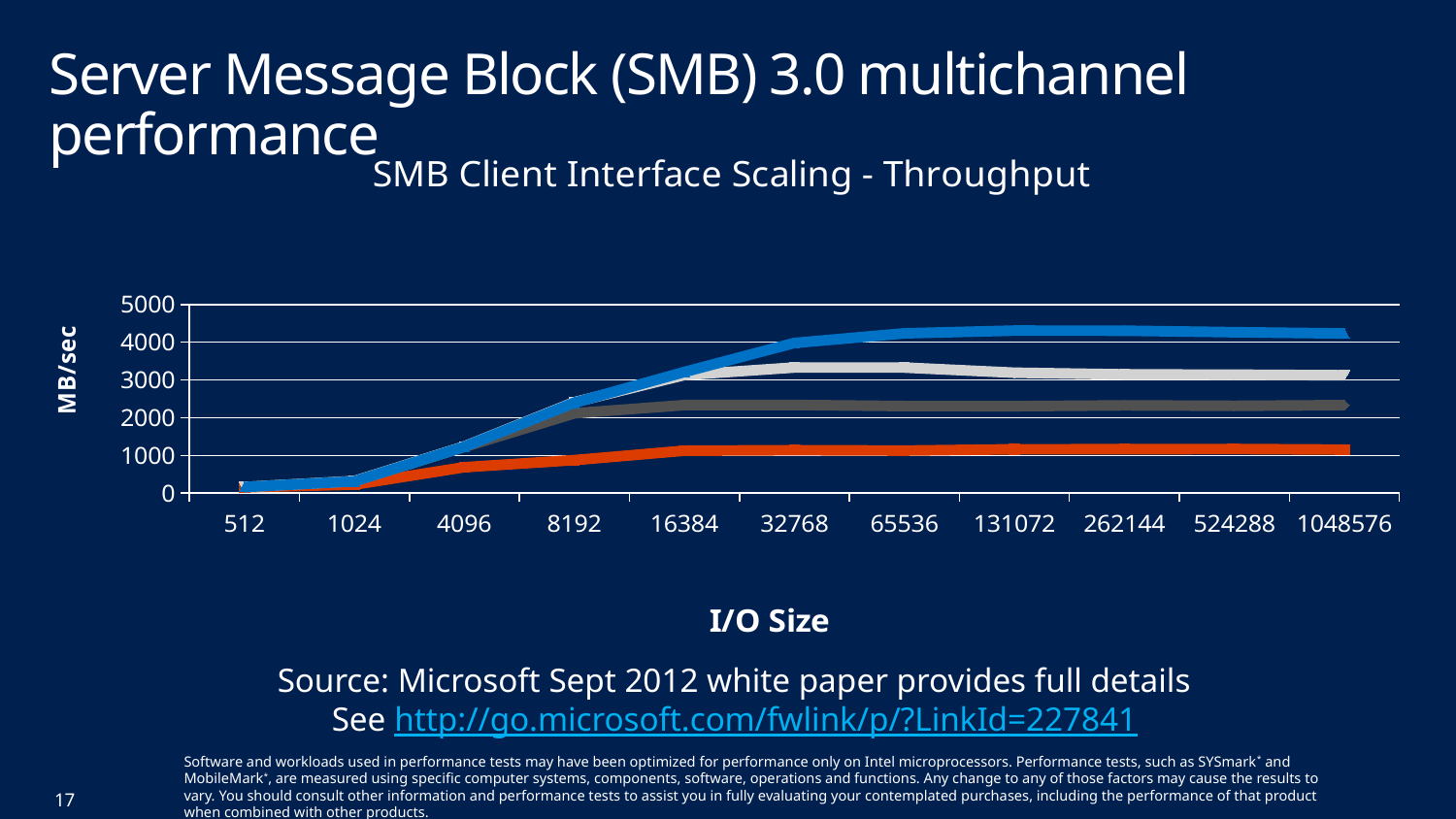
How many I/O size categories are shown on the x axis? 11 Is the value of the blue line at I/O size 512 greater or less than 1000? less Does the blue line generally rise or fall as I/O size increases from 512 to 32768? rise Is the value of the blue line at I/O size 1048576 greater or less than 4000? greater What kind of chart is shown on the slide? line chart What is the title of the chart? SMB Client Interface Scaling - Throughput Is the value of the orange line at I/O size 1048576 greater or less than 2000? less Which line has the lowest value at I/O size 1048576? the orange line At I/O size 65536, which line has the larger value, the blue line or the orange line? the blue line What is the label of the y axis? MB/sec Which line has the highest value at I/O size 1048576? the blue line